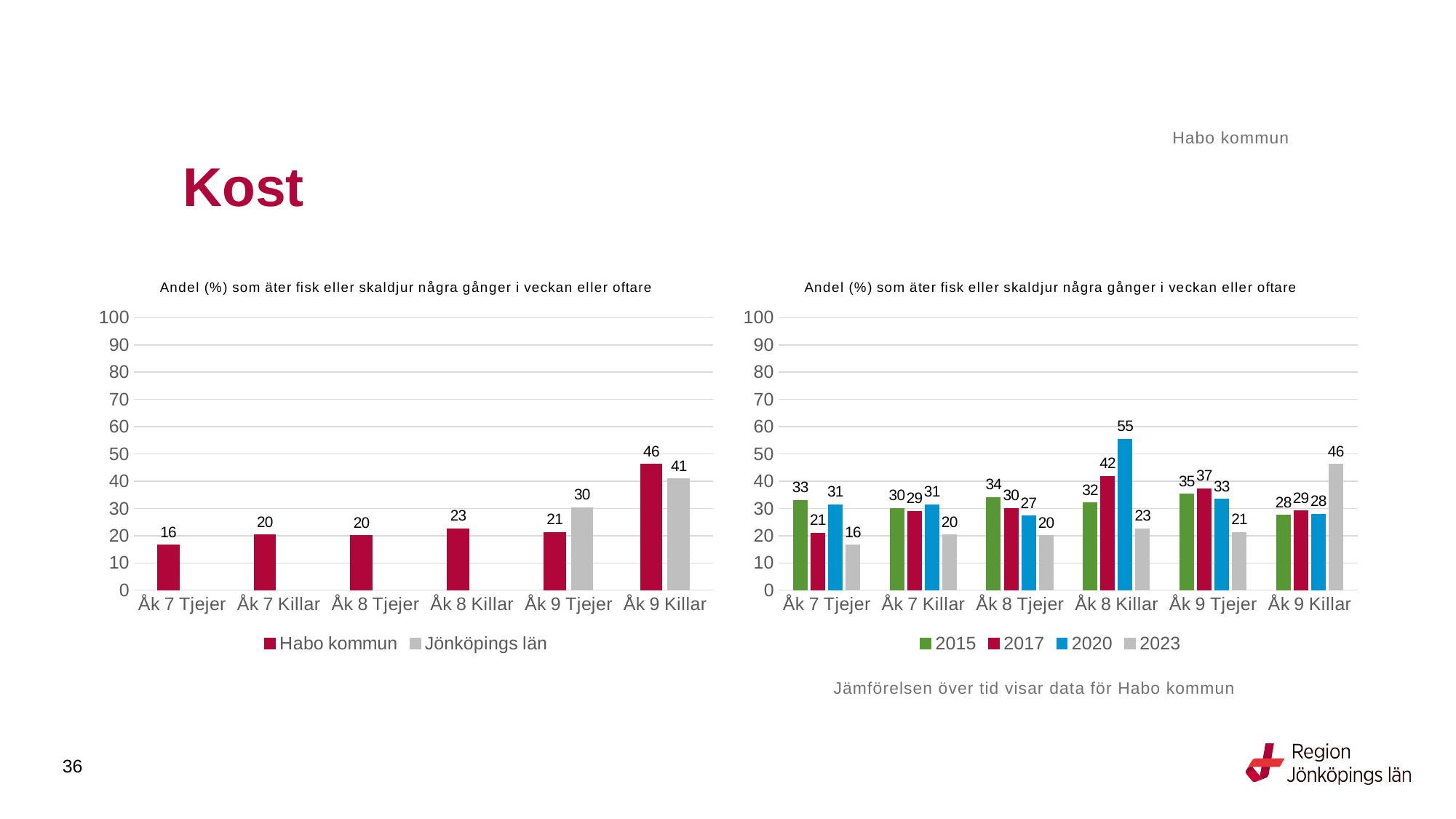
In the left chart, what is the value for Habo kommun for Åk 9 Killar? 46 In the right chart, how many series does the legend list? 4 In the right chart, what is the value for 2020 for Åk 8 Killar? 55 In the right chart, which category has the highest value for 2023? Åk 9 Killar In the left chart, what is the difference between Habo kommun and Jönköpings län for Åk 9 Killar? 5 In the right chart, what is the value for 2023 for Åk 7 Tjejer? 16 In the right chart, what is the difference between the 2020 and 2023 values for Åk 8 Killar? 32 In the left chart, what is the value for Jönköpings län for Åk 9 Tjejer? 30 In the right chart, which is larger for Åk 8 Killar: the 2017 value or the 2023 value? 2017 In the left chart, how many series does the legend list? 2 What kind of chart is the right chart? Bar chart In the left chart, which category has the lowest value for Habo kommun? Åk 7 Tjejer